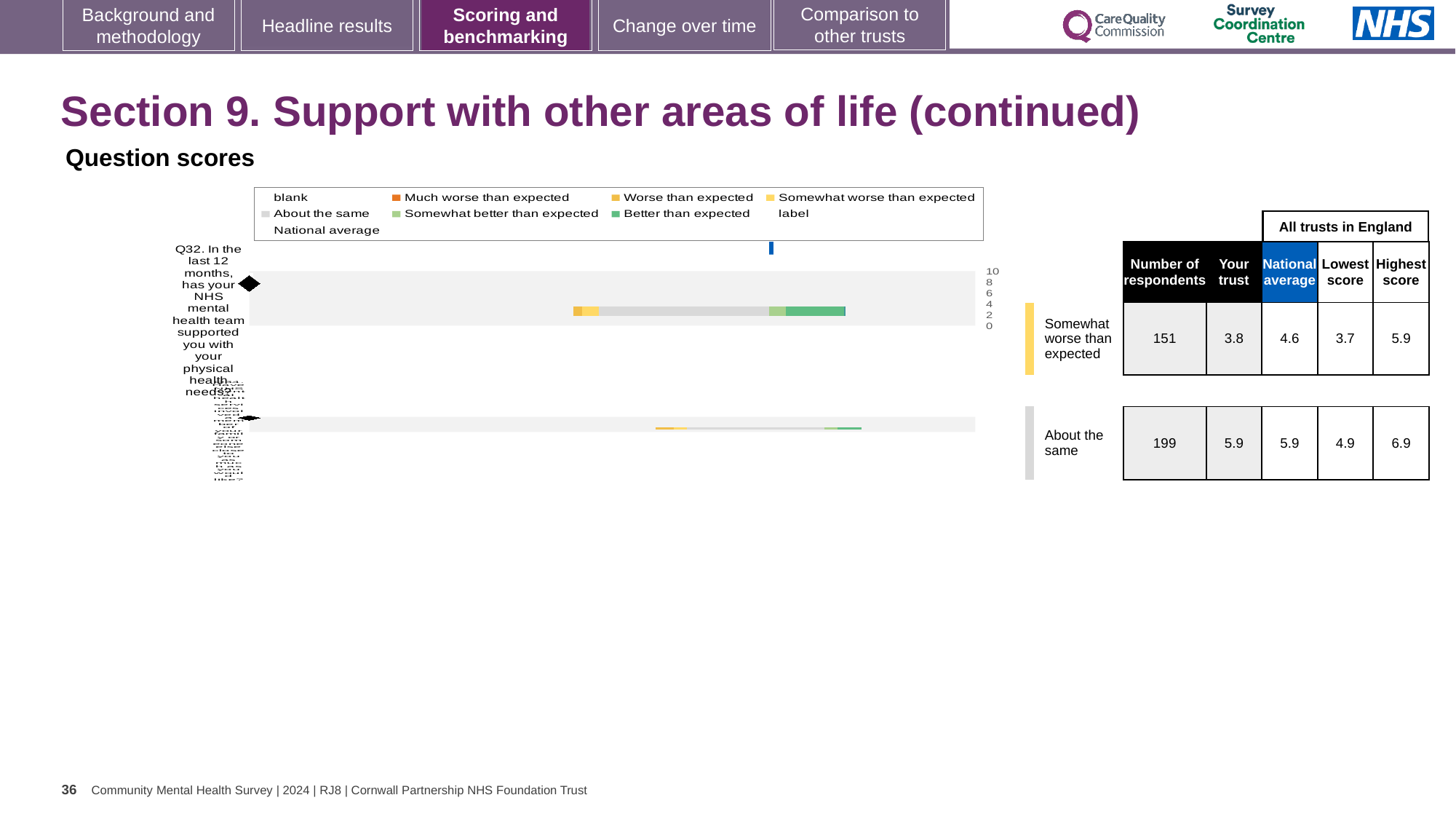
Which benchmarking category is Q32 placed in? Somewhat worse than expected What kind of chart is shown on the slide? bar chart What is the difference between the national average and the trust's score for Q32? 0.8 What is the maximum value shown on the chart's score axis? 10 What is the lowest score among all trusts in England for Q32? 3.7 What is the highest score among all trusts in England for Q32? 5.9 How many entries does the chart legend list? 9 What is the 'Your trust' score for the second (lower) question row on the chart? 5.9 What is the national average score for Q32? 4.6 What is the 'Your trust' score for Q32 (support with physical health needs)? 3.8 How many respondents answered Q32? 151 Which is larger for Q32: the trust's score or the national average? National average